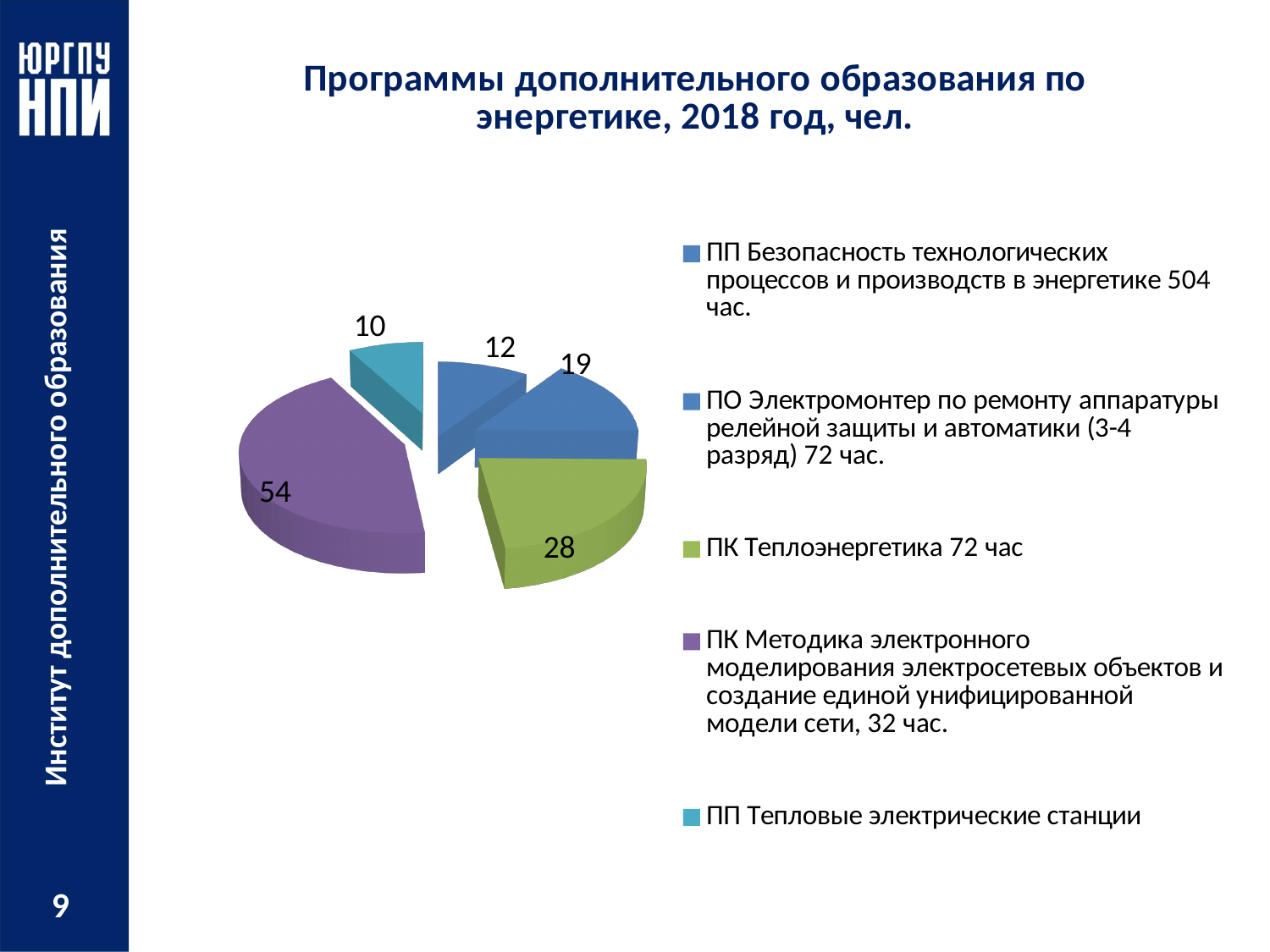
What is the value for ПК Теплоэнергетика 72 час? 28 Which category has the smallest slice of the pie? ПП Тепловые электрические станции Which category has the largest slice of the pie? ПК Методика электронного моделирования электросетевых объектов и создание единой унифицированной модели сети, 32 час. What is the title of the chart? Программы дополнительного образования по энергетике, 2018 год, чел. What colour is the slice for ПК Теплоэнергетика 72 час? green Which is larger: the value for ПК Теплоэнергетика 72 час or the value for ПП Тепловые электрические станции? ПК Теплоэнергетика 72 час What type of chart is shown on the slide? pie chart What is the value for ПК Методика электронного моделирования электросетевых объектов и создание единой унифицированной модели сети, 32 час.? 54 What is the difference between the value for ПК Методика электронного моделирования (54) and ПК Теплоэнергетика 72 час (28)? 26 What is the total of all the values shown on the pie chart? 123 What is the value for ПП Тепловые электрические станции? 10 How many slices does the pie chart have? 5